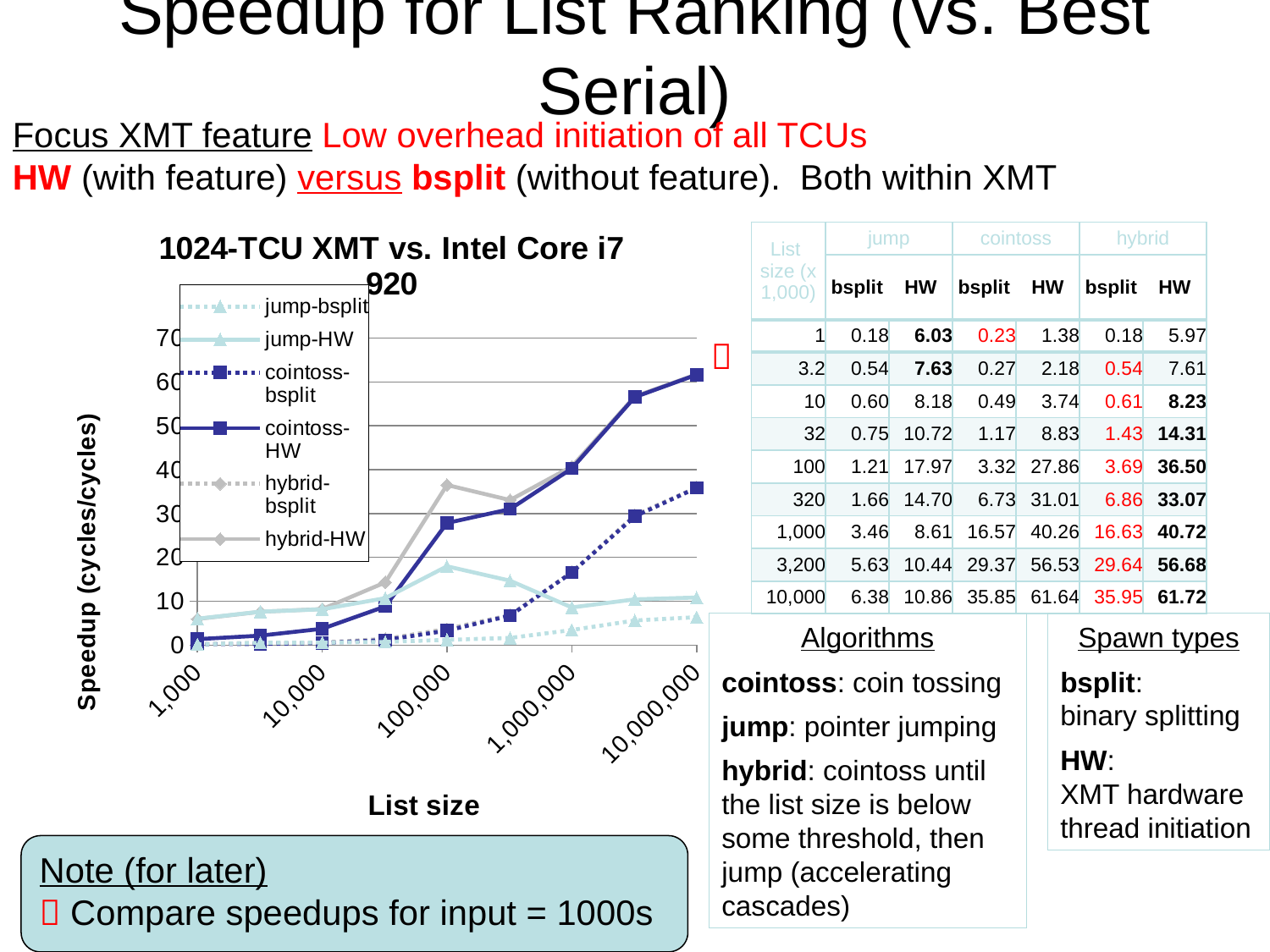
Is the value for cointoss-HW at list size 1,000,000 greater or less than 30? greater What is the label on the chart's y axis? Speedup (cycles/cycles) How many data points does each series in the chart have? 9 How many series does the chart legend list? 6 Does the cointoss-HW series rise or fall as list size increases along the x axis? rises Is the value for jump-HW at list size 100,000 greater or less than 20? less According to the table, which is larger at list size 100 (x 1,000): the jump HW speedup or the cointoss HW speedup? cointoss HW What kind of chart is shown on the slide? line chart According to the table, which algorithm/spawn type combination has the lowest speedup for list size 10,000 (x 1,000)? jump bsplit What is the title of the chart? 1024-TCU XMT vs. Intel Core i7 920 According to the table, what is the difference between the hybrid HW and hybrid bsplit speedups for list size 10,000 (x 1,000)? 25.77 According to the table, what is the cointoss HW speedup for list size 10,000 (x 1,000)? 61.64